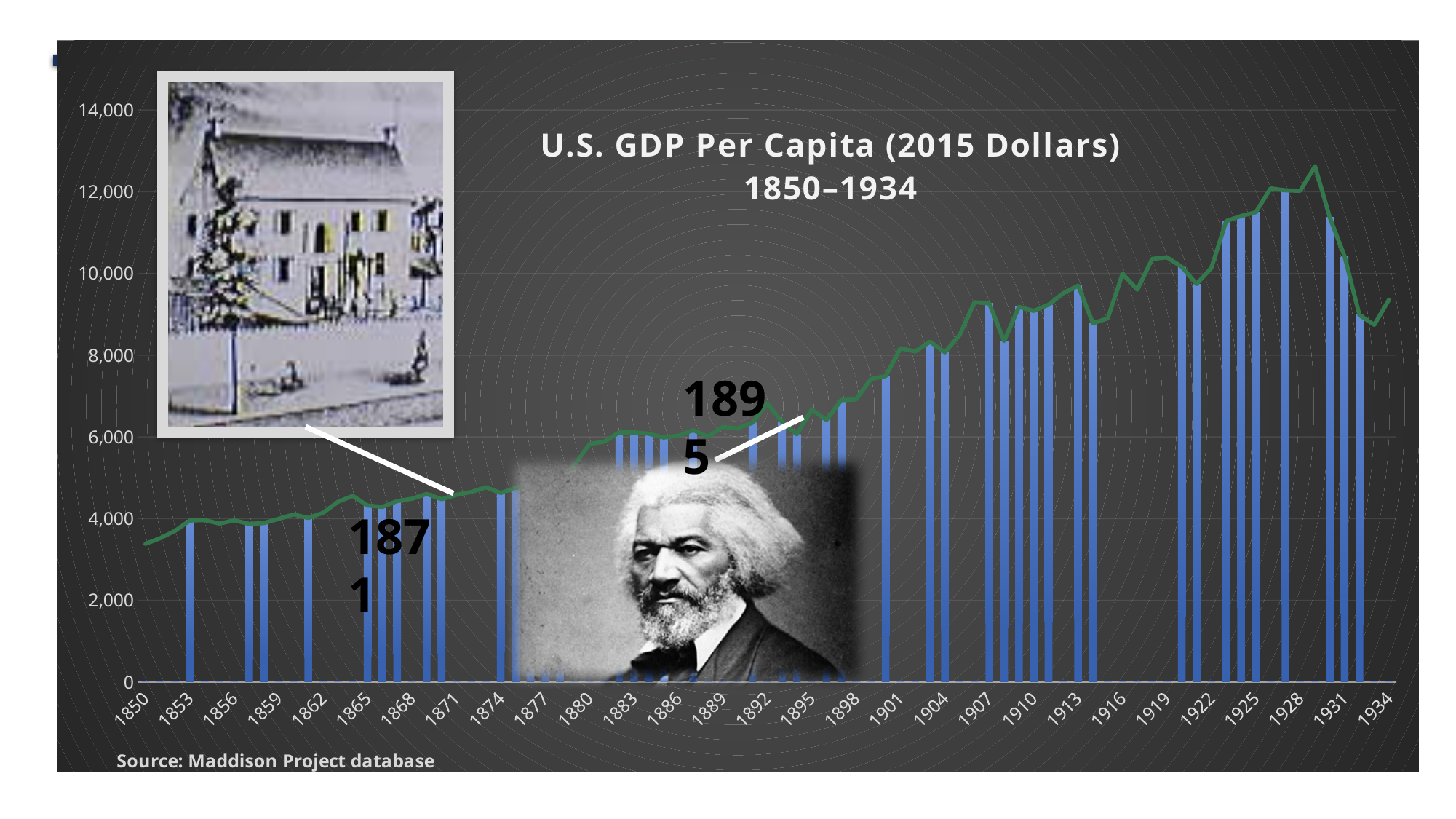
Is the value for 1922 greater or less than 12,000? less What source is cited for the chart data? Maddison Project database Is the value for 1928 greater or less than 10,000? greater Which is larger, the value for 1928 or the value for 1850? 1928 What is the title of the chart? U.S. GDP Per Capita (2015 Dollars) 1850–1934 Is the value for 1934 greater or less than 10,000? less What kind of chart is shown on the slide? A combined bar and line chart Do the values generally rise or fall from 1850 to 1934? Rise Which year shown on the x axis has the lowest value? 1850